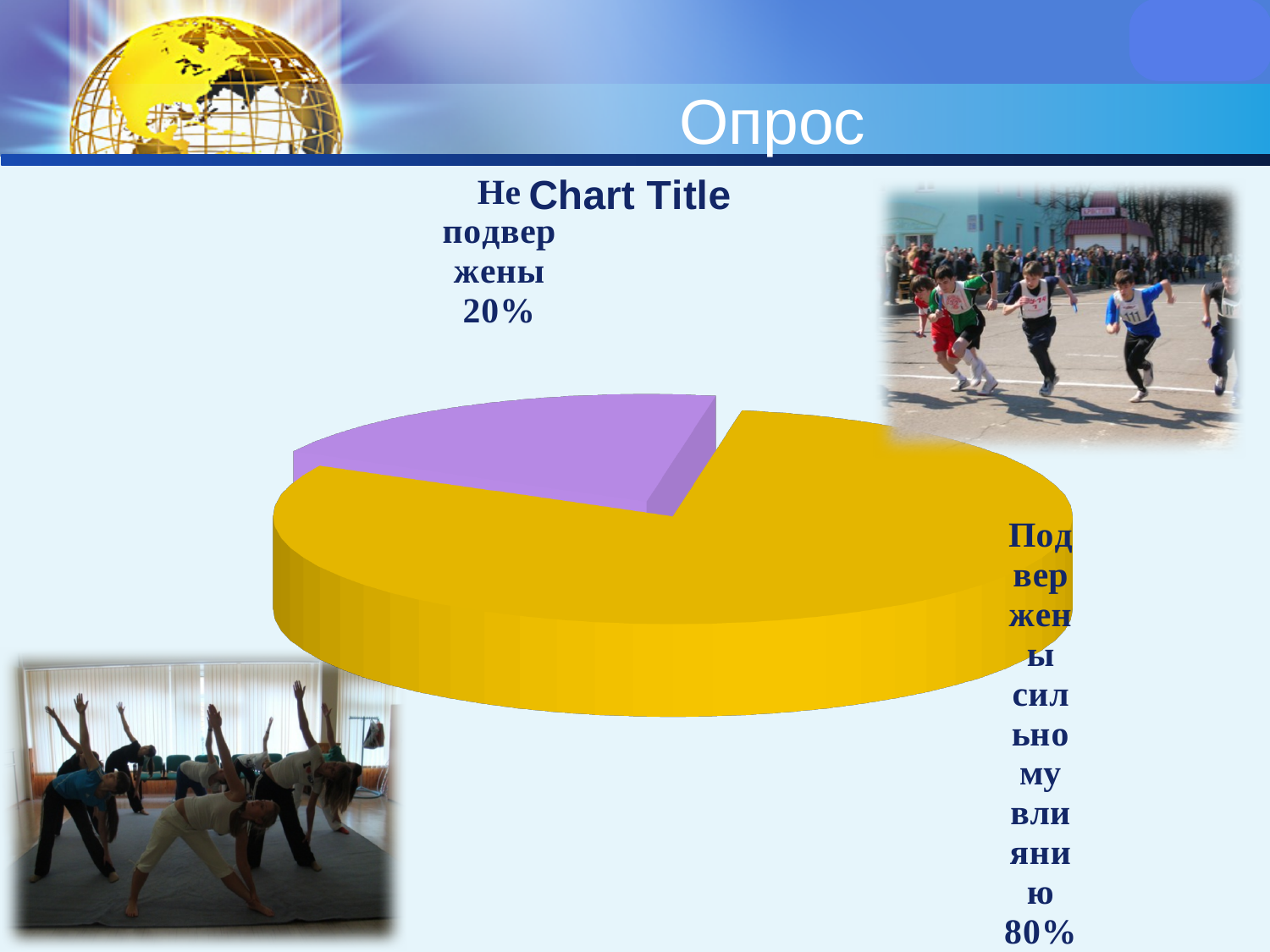
What colour is the "Не подвержены" slice of the pie chart? purple What share of the pie is labelled "Не подвержены"? 20% What share of the pie is labelled "Подвержены сильному влиянию"? 80% How many slices does the pie chart have? 2 What kind of chart is shown on the slide? pie chart Which slice of the pie chart is the largest? Подвержены сильному влиянию Which is larger: the share for "Не подвержены" or the share for "Подвержены сильному влиянию"? Подвержены сильному влиянию Which slice of the pie chart is the smallest? Не подвержены What is the title printed above the pie chart? Chart Title What is the difference in percentage points between the "Подвержены сильному влиянию" slice and the "Не подвержены" slice? 60 percentage points